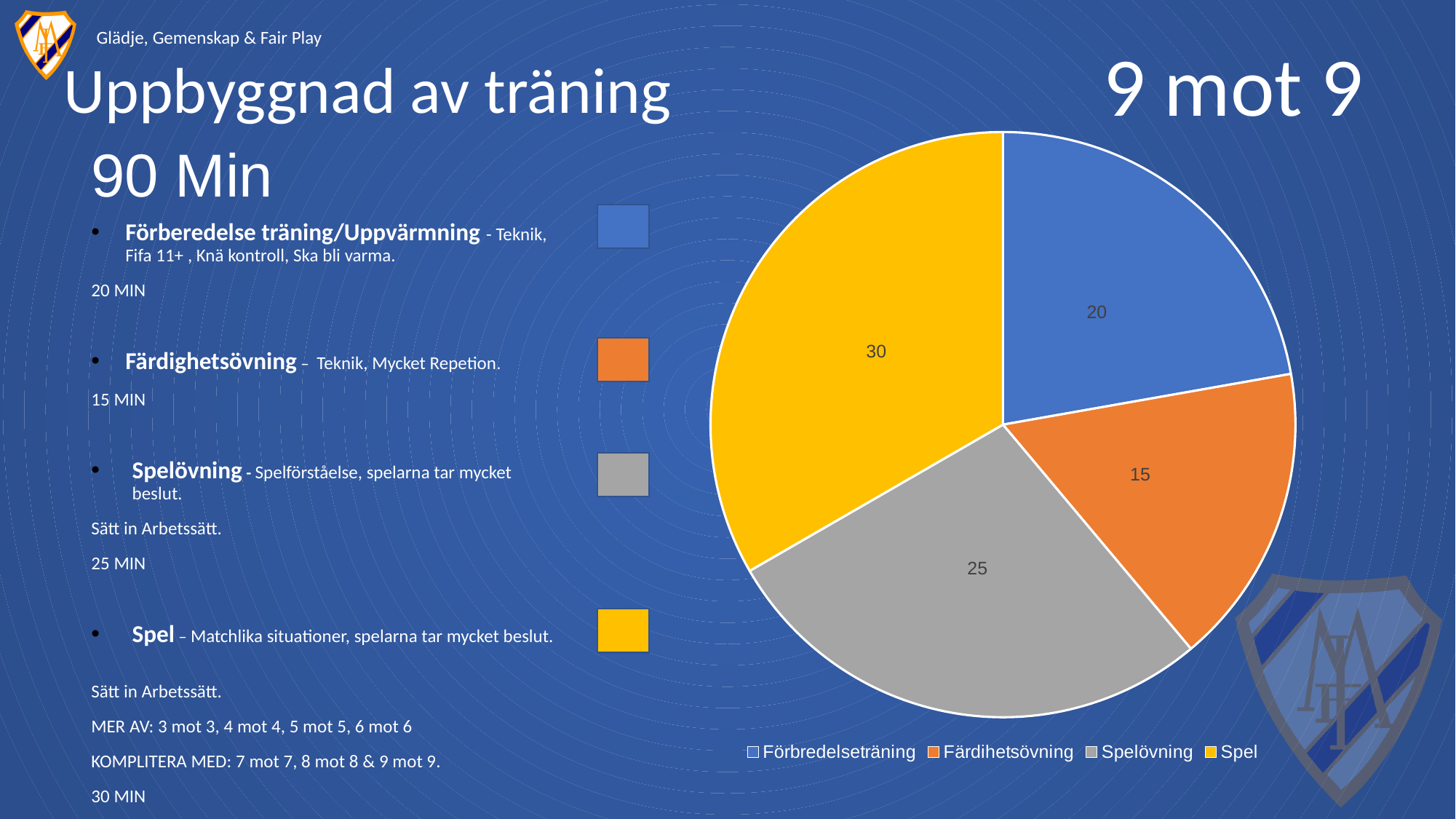
What kind of chart is shown on the slide? pie chart What is the value for Spelövning in the pie chart? 25 Which category has the largest slice in the pie chart? Spel What share of the pie does the Spel slice represent? 33.3% What colour is the Spel slice in the pie chart? yellow Which is larger, the value for Spelövning or the value for Förbredelseträning? Spelövning What is the difference between the values for Spel and Färdihetsövning? 15 How many slices does the pie chart have? 4 What is the value for Förbredelseträning in the pie chart? 20 What is the value for Spel in the pie chart? 30 Which category has the smallest slice in the pie chart? Färdihetsövning What is the value for Färdihetsövning in the pie chart? 15